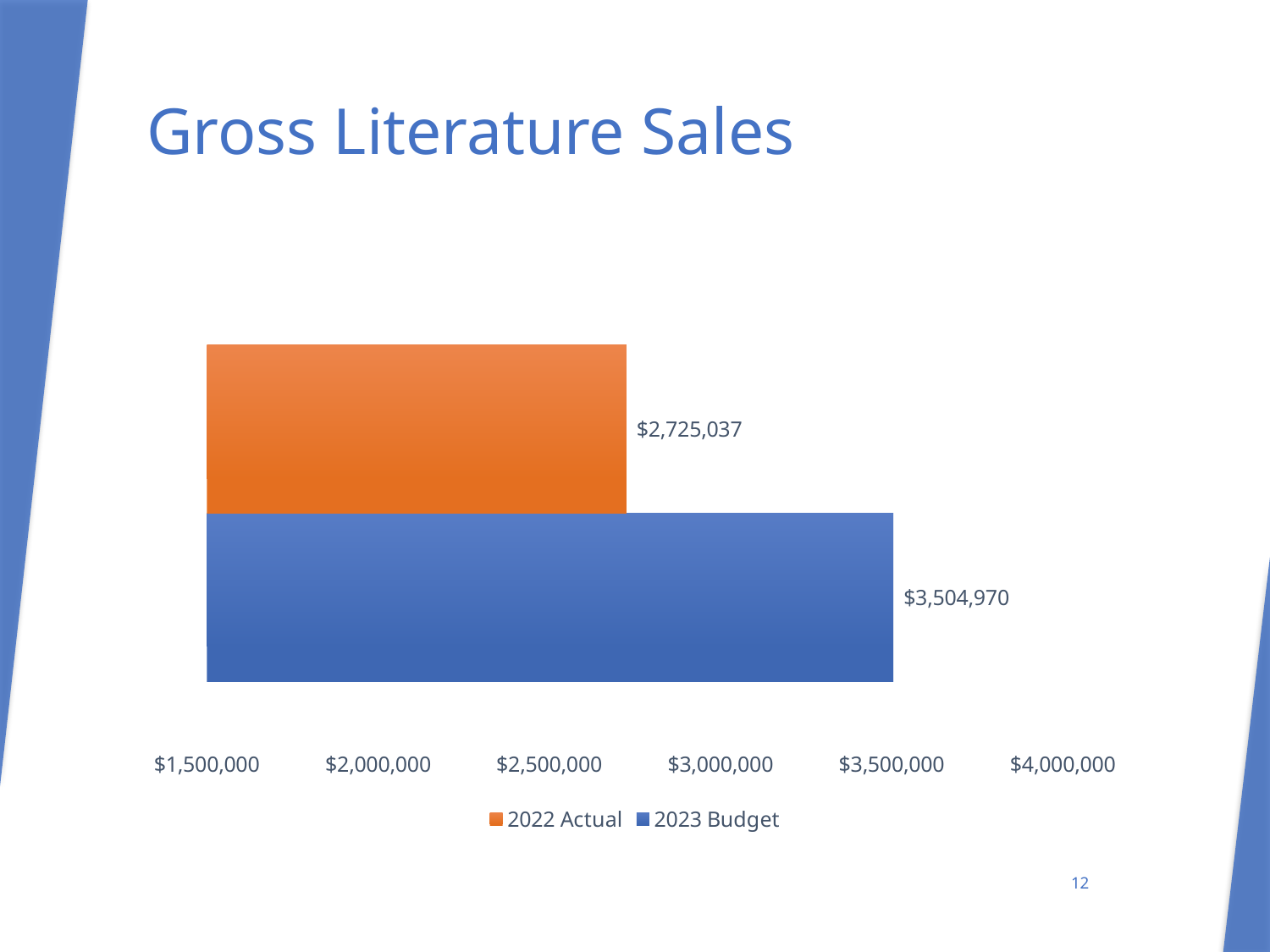
What kind of chart is shown on the slide? bar chart Which series has the lowest value? 2022 Actual What is the title of the slide? Gross Literature Sales Which series has the higher value, 2022 Actual or 2023 Budget? 2023 Budget What is the difference between the 2023 Budget and the 2022 Actual values? $779,933 Is the value for 2022 Actual greater or less than $3,000,000? less What is the highest value shown on the x axis? $4,000,000 What is the value for 2023 Budget? $3,504,970 Is the value for 2023 Budget greater or less than $3,500,000? greater What is the value for 2022 Actual? $2,725,037 How many series does the legend list? 2 What colour is the bar for 2022 Actual? orange